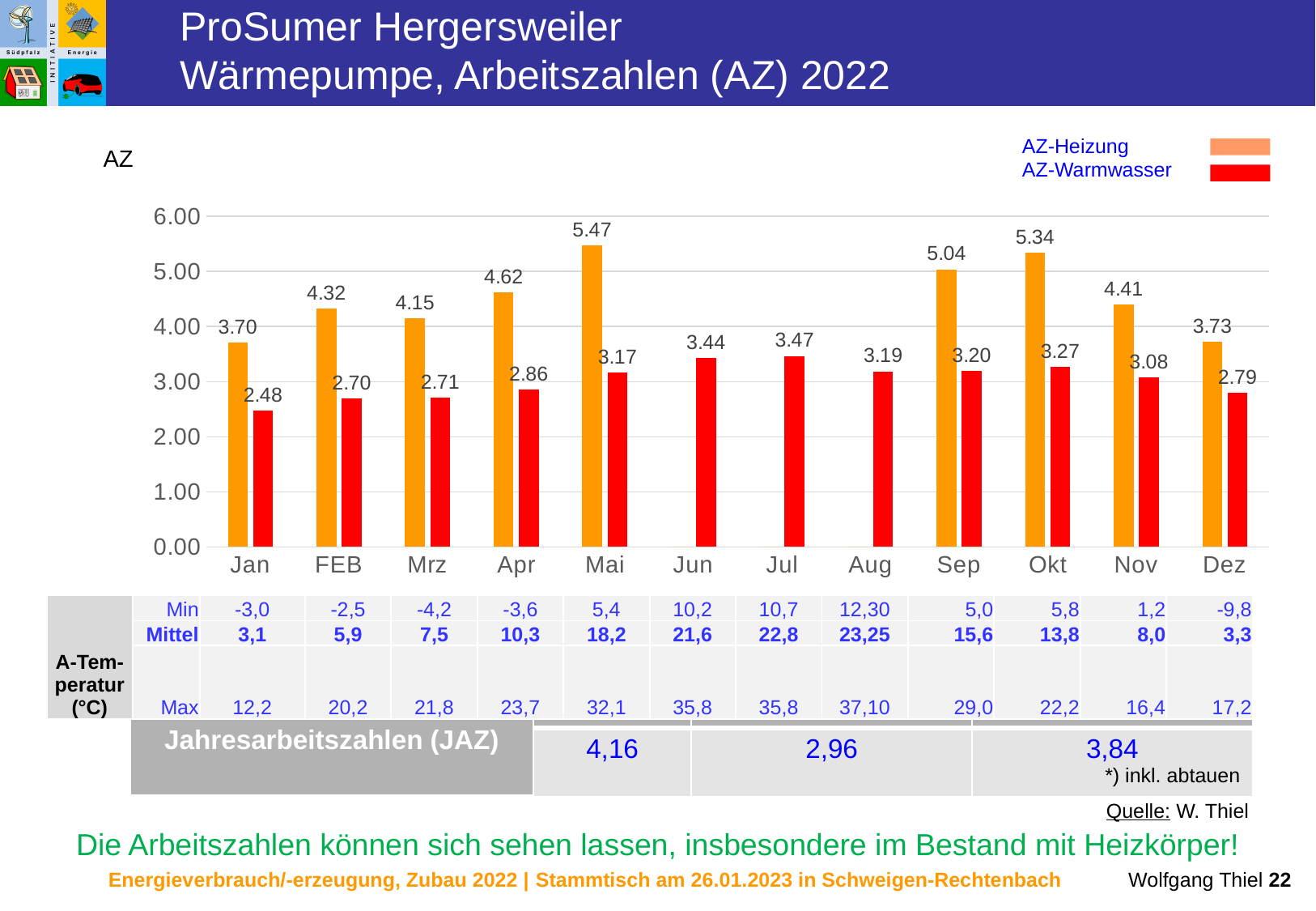
What is the AZ-Heizung value for Mai? 5.47 What is the AZ-Warmwasser value for Jul? 3.47 Which month has the lowest AZ-Warmwasser value? Jan How many months are shown on the x axis of the chart? 12 What kind of chart is shown on the slide? bar chart Do the AZ-Warmwasser values rise or fall from Jan to Jul? rise Which month has the highest AZ-Heizung value? Mai What is the difference between the AZ-Heizung and AZ-Warmwasser values in Mai? 2.30 Is the AZ-Warmwasser value for Jan greater or less than 3.00? less How many series does the chart legend list? 2 What is the AZ-Heizung value for Okt? 5.34 Which is larger, the AZ-Heizung value for Apr or for Nov? Apr